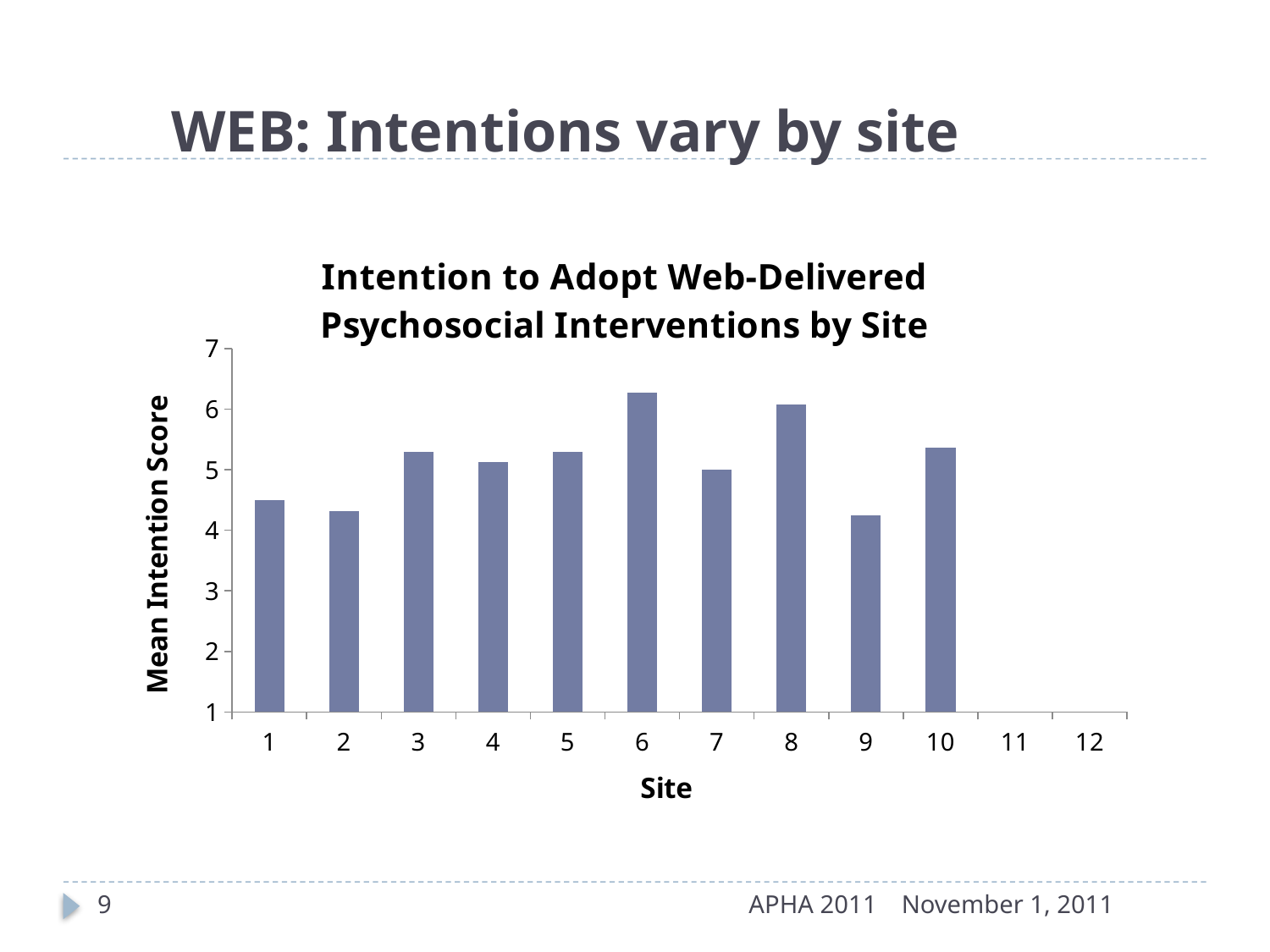
Is the mean intention score for site 6 greater or less than 6? greater Is the mean intention score for site 9 greater or less than 5? less Which has a higher mean intention score, site 9 or site 3? site 3 Is the mean intention score for site 3 greater or less than 5? greater Which has a higher mean intention score, site 8 or site 2? site 8 What kind of chart is shown on the slide? bar chart What is the title of the chart? Intention to Adopt Web-Delivered Psychosocial Interventions by Site Which site has the highest mean intention score? 6 What is the label of the vertical axis? Mean Intention Score How many sites have a bar plotted in the chart? 10 How many site labels appear on the horizontal axis? 12